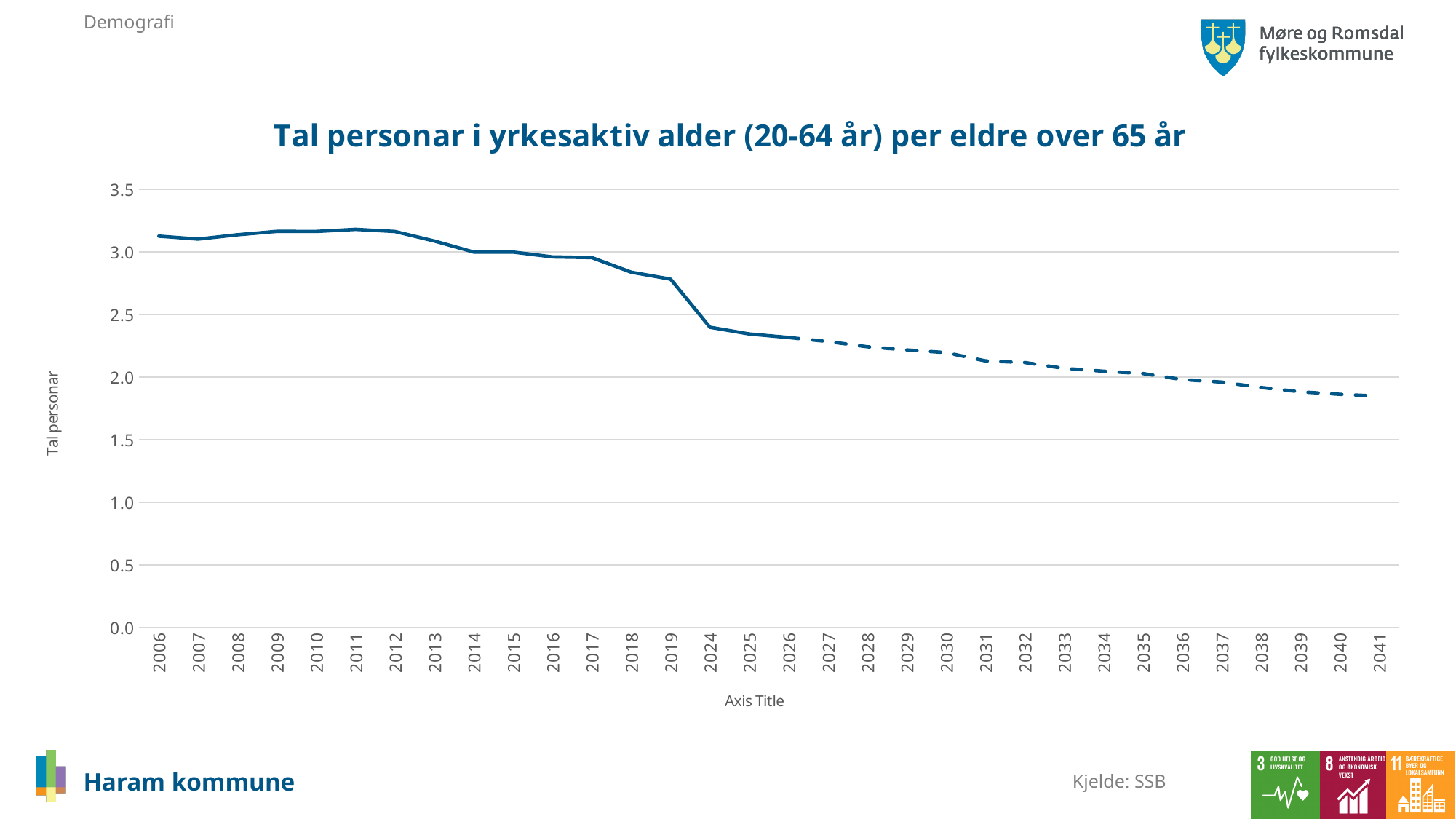
Which year has the lowest value on the chart? 2041 What is the label on the vertical axis of the chart? Tal personar Is the value for 2041 greater or less than 2.0? less Is the value for 2006 greater or less than 3.0? greater How many years are shown on the x axis of the chart? 32 Is the value for 2024 greater or less than 2.5? less Which is larger, the value for 2012 or the value for 2041? 2012 What is the title of the chart? Tal personar i yrkesaktiv alder (20-64 år) per eldre over 65 år Do the values generally rise or fall from 2006 to 2041? fall Which is larger, the value for 2019 or the value for 2024? 2019 What kind of chart is shown on the slide? line chart